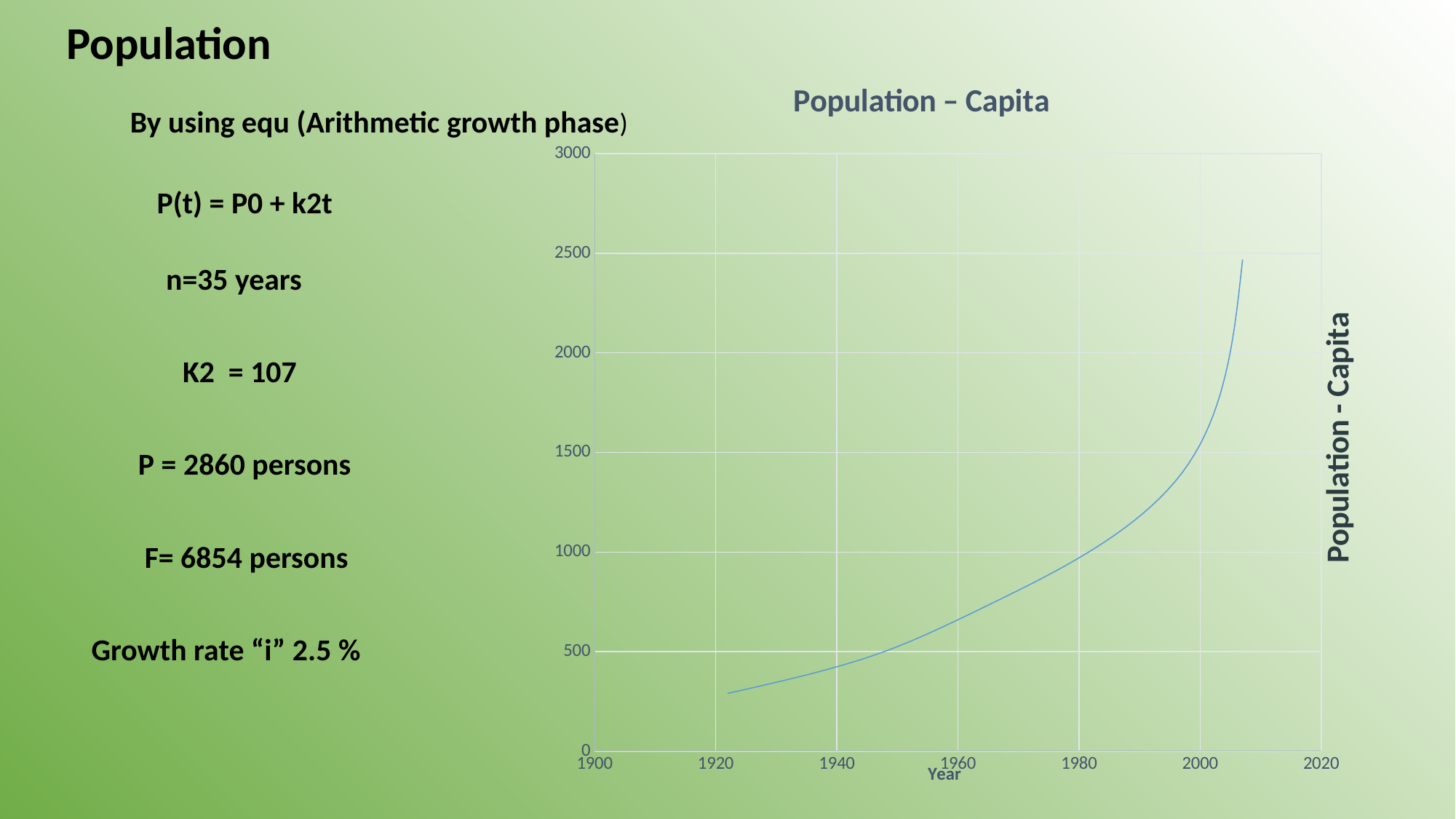
What is the title of the chart? Population – Capita Is the value for the year 1940 greater or less than 500? less Is the highest point on the curve greater or less than 2000? greater Is the value for the year 2000 greater or less than 1000? greater Which year has the larger plotted value, 1940 or 1980? 1980 Does the plotted population rise or fall as the year increases? rise What is the label of the x axis of the chart? Year What kind of chart is shown on the slide? line chart